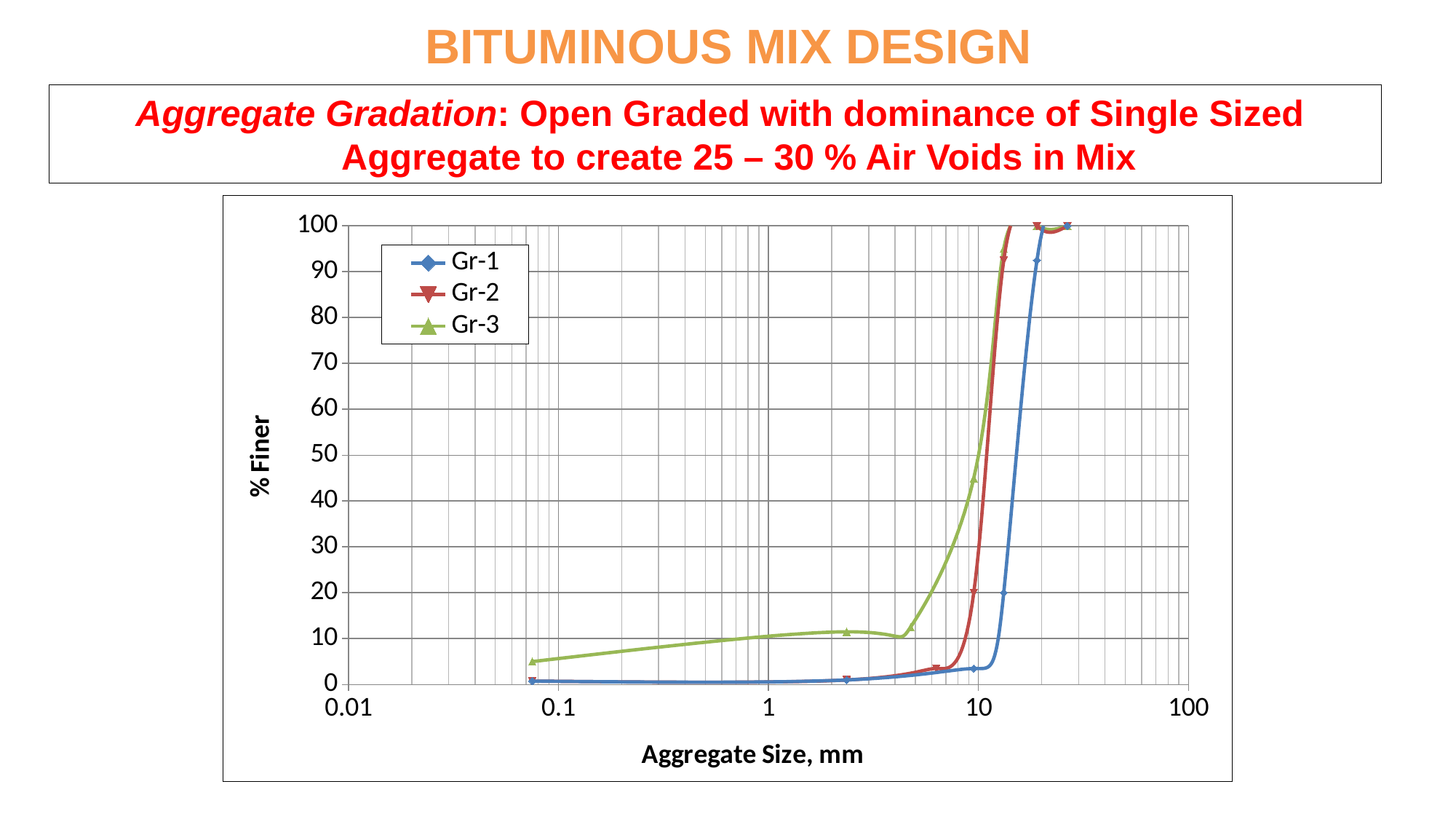
At an aggregate size of 10 mm, which series has the higher % Finer, Gr-1 or Gr-3? Gr-3 What kind of chart is shown on the slide? Line chart Is the % Finer value for Gr-1 at an aggregate size of 10 mm greater or less than 10? less How many series does the chart legend list? 3 Is the % Finer value for Gr-3 at an aggregate size of 10 mm greater or less than 30? greater Which series reaches 100% Finer at the largest aggregate size? Gr-1 What is the title of the vertical axis of the chart? % Finer Is the % Finer value for Gr-1 at an aggregate size of 20 mm greater or less than 80? greater At an aggregate size of 10 mm, which of the three series has the highest % Finer? Gr-3 Do the % Finer values for Gr-1 rise or fall as aggregate size increases along the x axis? Rise What are the names of the series listed in the chart legend? Gr-1, Gr-2, Gr-3